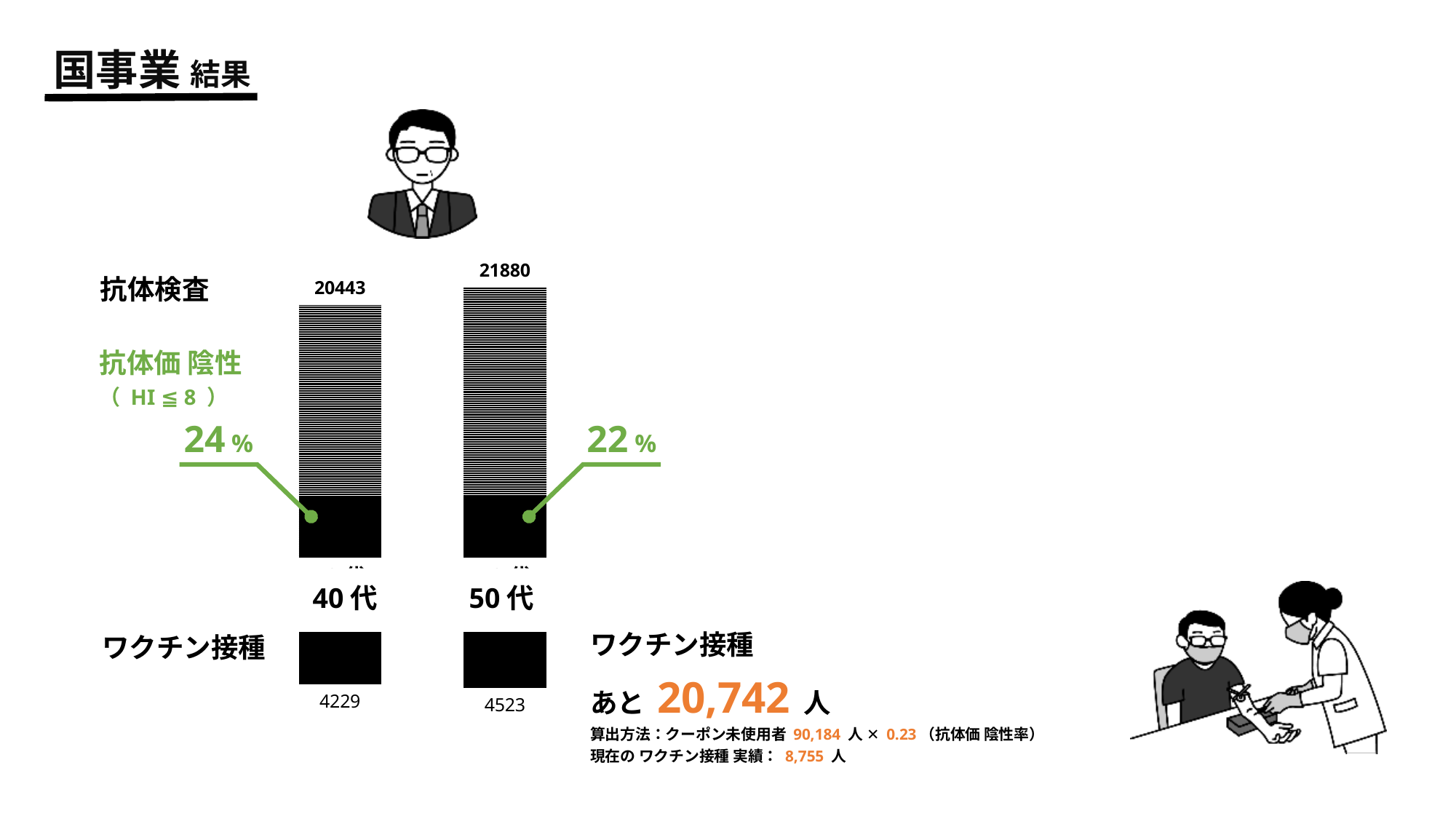
Which age group has the higher 抗体検査 value? 50代 What is the 抗体検査 value for 50代? 21880 How many age groups are shown in the chart? 2 What is the 抗体検査 value for 40代? 20443 What is the ワクチン接種 value for 40代? 4229 What is the difference between the 抗体検査 values for 50代 and 40代? 1437 What percentage of 40代 is labelled 抗体価 陰性 (HI ≦ 8)? 24% What is the ワクチン接種 value for 50代? 4523 What kind of chart is used to show the 抗体検査 results? Bar chart What is the difference between the ワクチン接種 values for 50代 and 40代? 294 What percentage of 50代 is labelled 抗体価 陰性 (HI ≦ 8)? 22% Which age group has the lower ワクチン接種 value? 40代